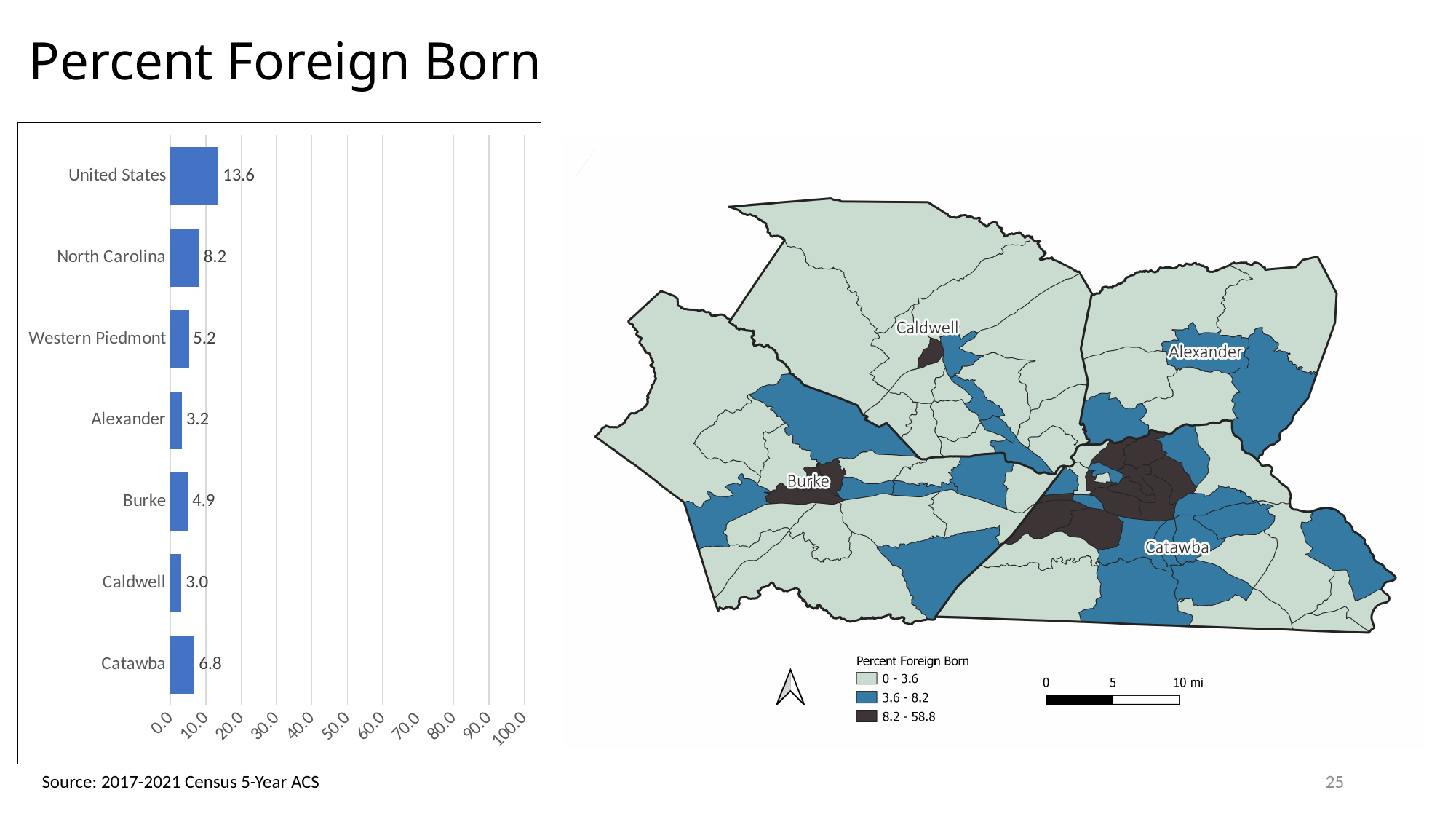
What is the percent foreign born value for Catawba in the bar chart? 6.8 Which has a larger value in the bar chart, Burke or Western Piedmont? Western Piedmont Which category has the lowest value in the bar chart? Caldwell Is the value for the United States in the bar chart greater or less than 10.0? greater How many categories are shown in the bar chart? 7 What is the percent foreign born value for Caldwell in the bar chart? 3.0 What kind of chart is shown on the left of the slide? bar chart Which category has the highest value in the bar chart? United States What is the percent foreign born value for North Carolina in the bar chart? 8.2 What is the percent foreign born value for the United States in the bar chart? 13.6 What is the difference between the United States value and the North Carolina value in the bar chart? 5.4 What is the difference between the Catawba value and the Alexander value in the bar chart? 3.6